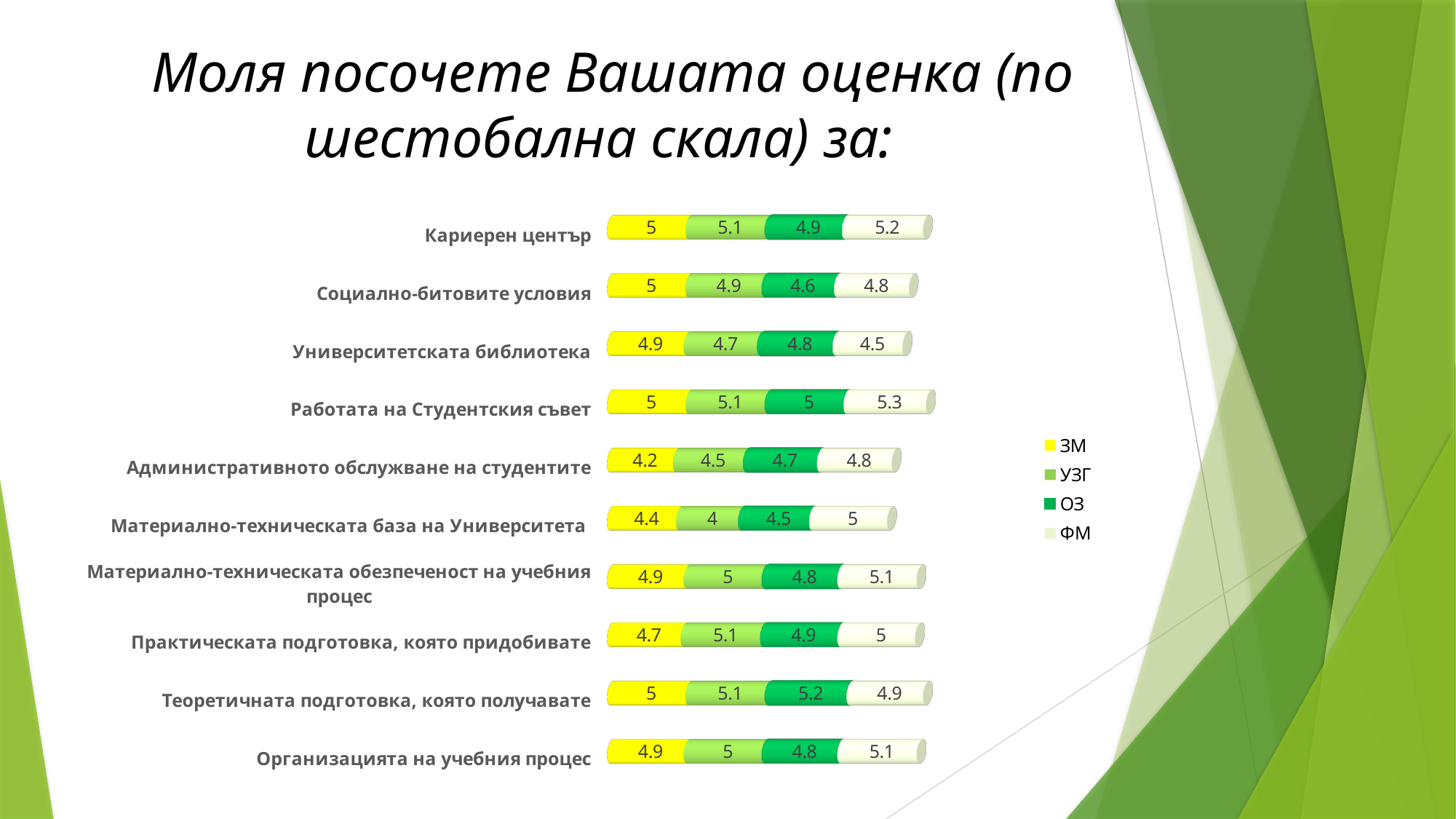
How many series does the legend list? 4 What type of chart is shown on the slide? stacked bar chart What is the ЗМ value for Кариерен център? 5 Which series is shown in yellow in the legend? ЗМ Which is larger for Социално-битовите условия: the УЗГ value or the ОЗ value? УЗГ Which category has the lowest ЗМ value? Административното обслужване на студентите What is the difference between the ФМ value and the ЗМ value for Административното обслужване на студентите? 0.6 Which category has the highest ОЗ value? Теоретичната подготовка, която получавате What is the total of the stacked bar for Работата на Студентския съвет? 20.4 What is the ФМ value for Работата на Студентския съвет? 5.3 How many categories are plotted in the chart? 10 What is the УЗГ value for Материално-техническата база на Университета? 4